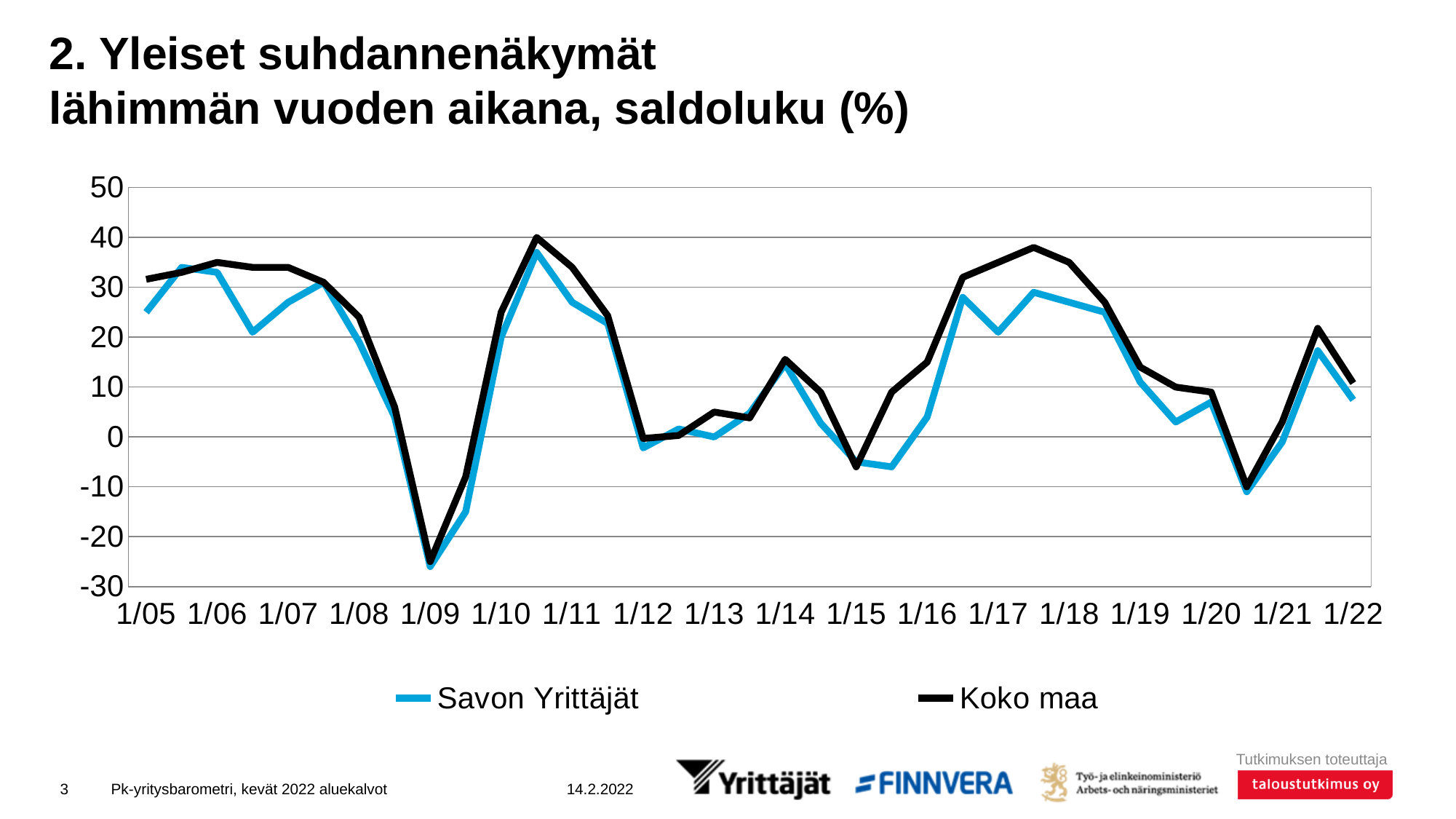
Which series is drawn with the black line? Koko maa How many series does the legend list? 2 Is the value for Koko maa at 1/09 greater or less than -20? less Between 1/18 and 1/20, does the Koko maa line rise or fall? fall Is the value for Savon Yrittäjät at 1/05 greater or less than 20? greater How many year labels are shown on the x axis? 18 At 1/17, which series has the higher value, Savon Yrittäjät or Koko maa? Koko maa At which x-axis label does the Koko maa line reach its lowest value? 1/09 What kind of chart is shown on the slide? line chart Is the value for Koko maa at 1/18 greater or less than 30? greater At 1/16, which series has the higher value, Savon Yrittäjät or Koko maa? Koko maa